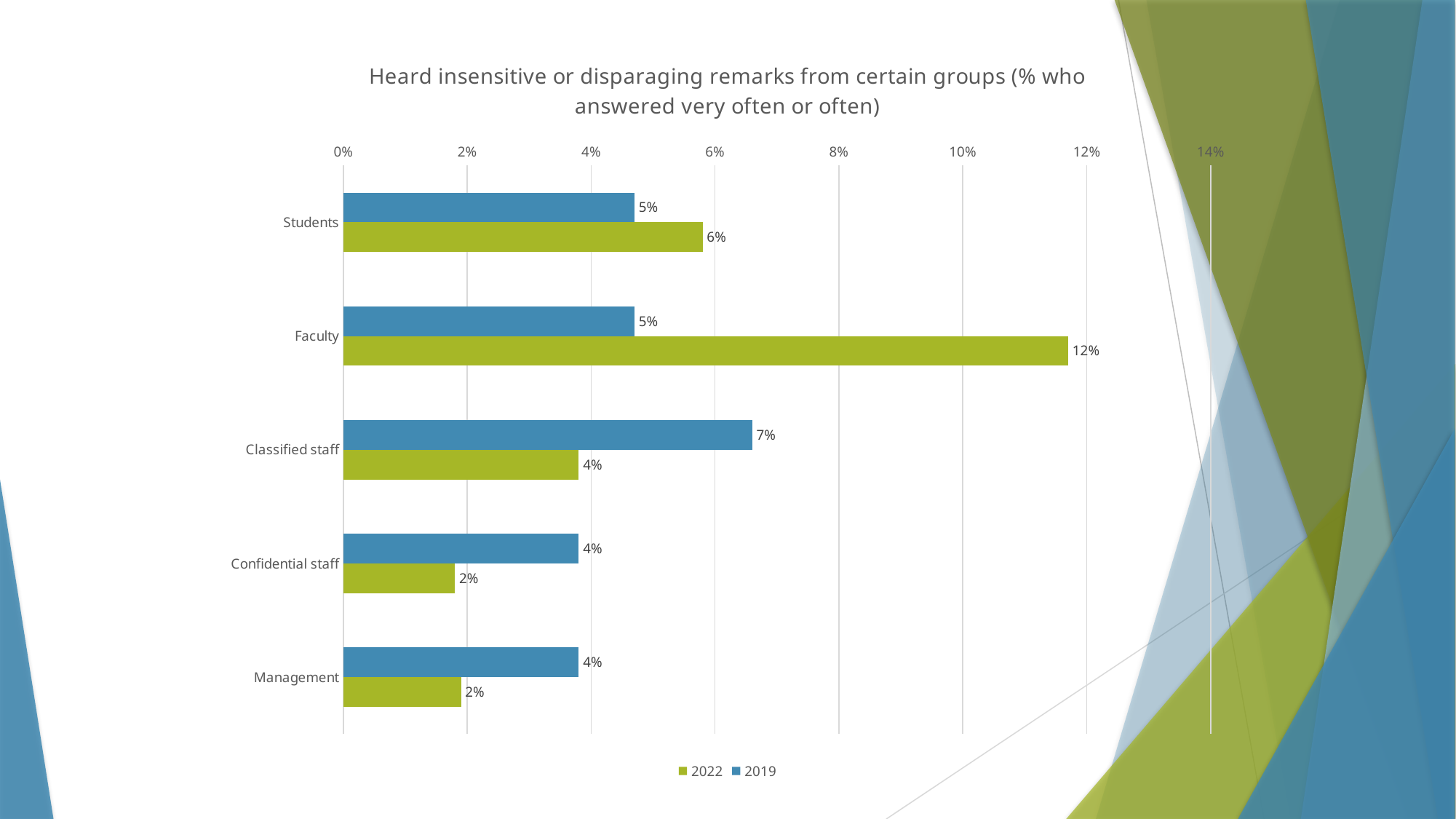
What is the 2022 value for Faculty? 12% What is the 2022 value for Students? 6% What is the difference between the 2022 and 2019 values for Faculty? 7% What is the 2019 value for Management? 4% For Classified staff, which year has the larger value, 2022 or 2019? 2019 Is the 2022 value for Faculty greater or less than 10%? greater What kind of chart is shown on the slide? Bar chart How many groups are shown on the chart? 5 Which group has the highest 2019 value? Classified staff What is the 2019 value for Classified staff? 7% How many series does the legend list? 2 Which group has the highest 2022 value? Faculty